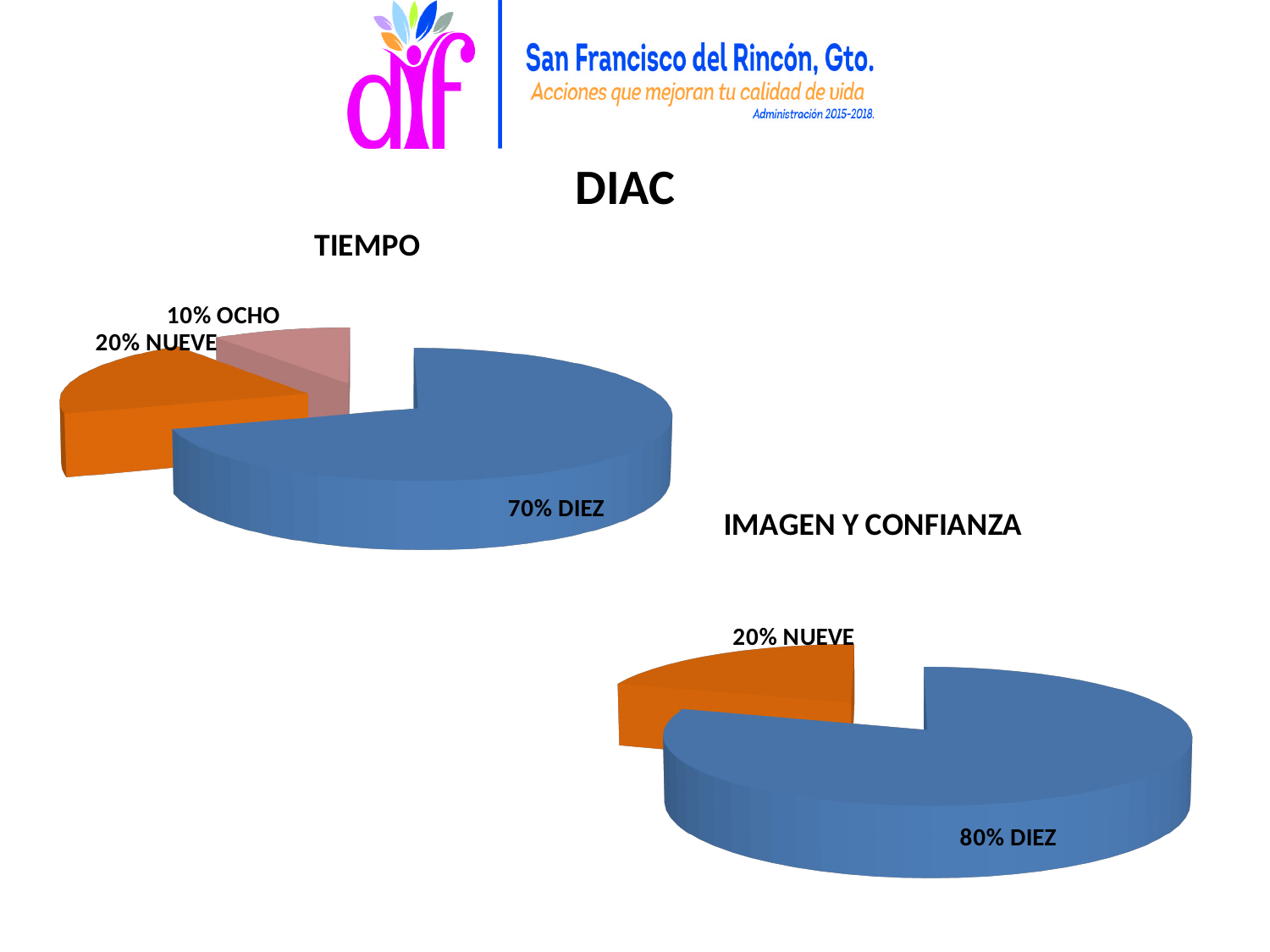
What kind of chart is the IMAGEN Y CONFIANZA chart? Pie chart In the TIEMPO chart, which category has the smallest slice? OCHO In the TIEMPO chart, what share of the pie is labelled DIEZ? 70% In the IMAGEN Y CONFIANZA chart, what share of the pie is labelled NUEVE? 20% In the IMAGEN Y CONFIANZA chart, what share of the pie is labelled DIEZ? 80% In the IMAGEN Y CONFIANZA chart, which is larger, the DIEZ slice or the NUEVE slice? DIEZ In the TIEMPO chart, which category has the largest slice? DIEZ In the TIEMPO chart, what is the difference in percentage points between the DIEZ slice and the NUEVE slice? 50 In the IMAGEN Y CONFIANZA chart, how many slices does the pie have? 2 In the TIEMPO chart, how many slices does the pie have? 3